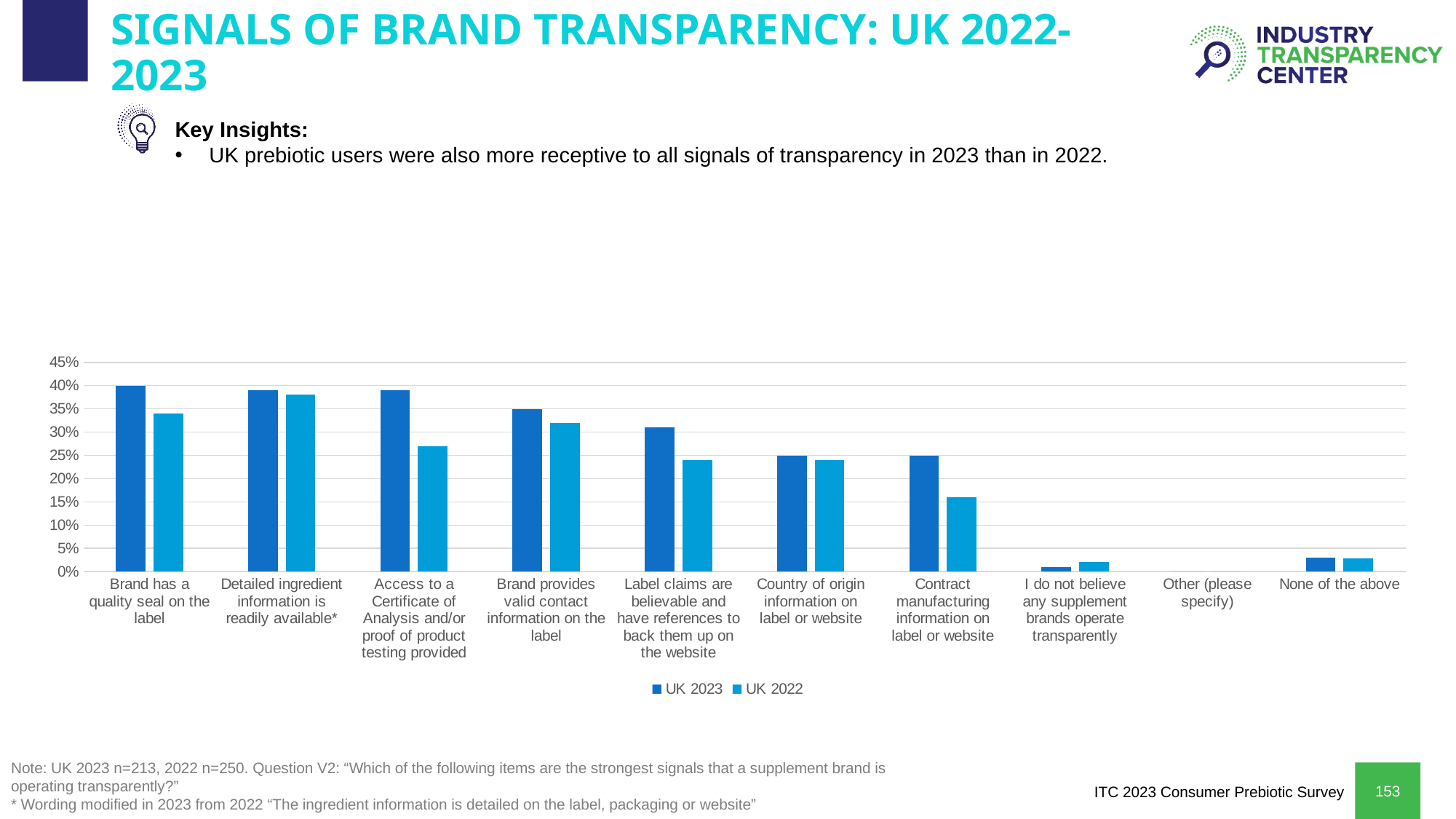
Is the UK 2023 value for 'Brand provides valid contact information on the label' greater or less than 30%? greater Is the UK 2022 value for 'Contract manufacturing information on label or website' greater or less than 20%? less How many categories are shown on the x axis of the chart? 10 What are the two series named in the legend? UK 2023 and UK 2022 Is the UK 2023 value for 'I do not believe any supplement brands operate transparently' greater or less than 5%? less For 'Contract manufacturing information on label or website', which is larger: UK 2023 or UK 2022? UK 2023 What kind of chart is shown on the slide? bar chart What is the UK 2023 value for 'Brand has a quality seal on the label'? 40% Which category has the highest UK 2022 value? Detailed ingredient information is readily available* How many series does the legend list? 2 For 'Brand has a quality seal on the label', which is larger: UK 2023 or UK 2022? UK 2023